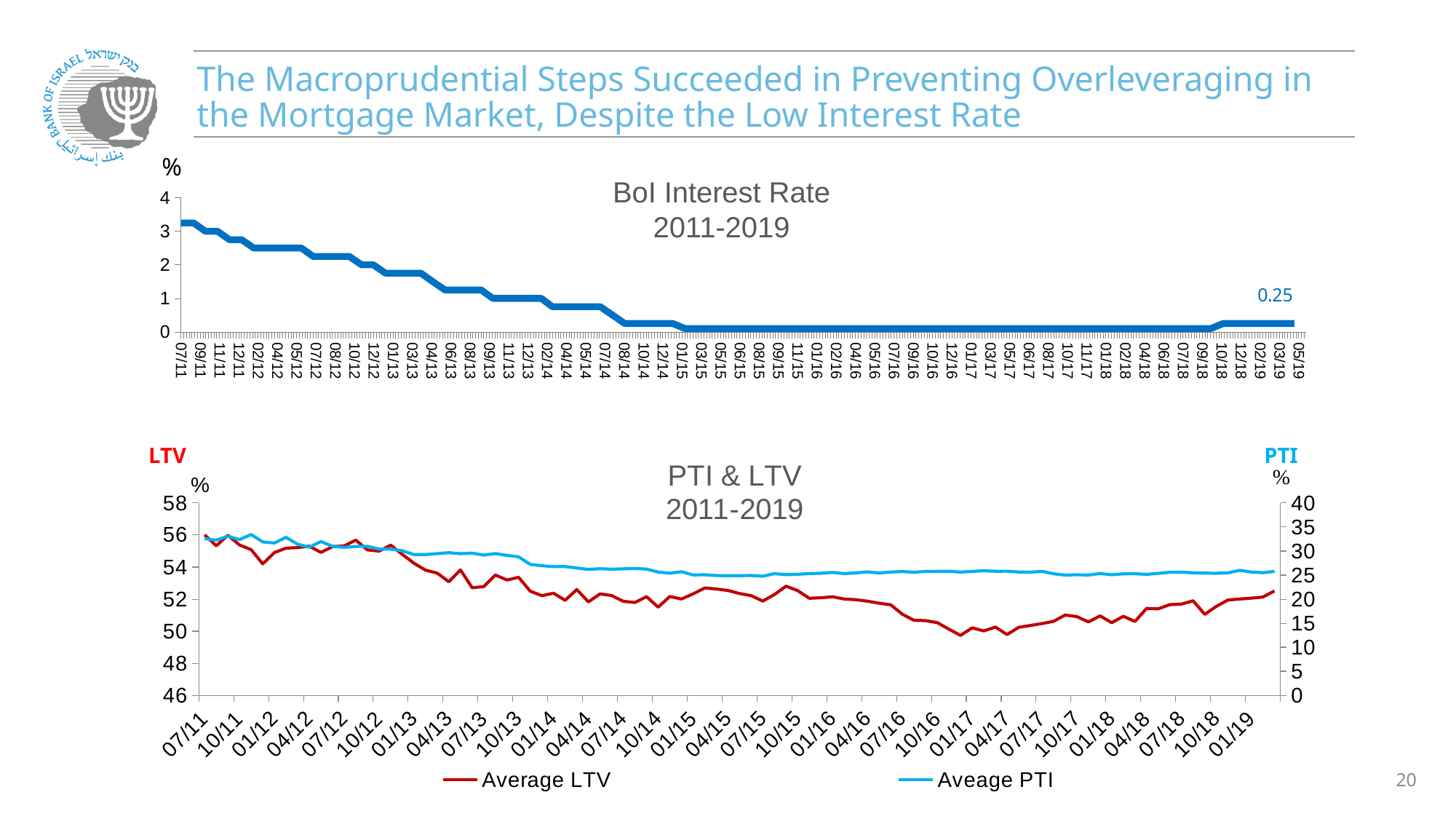
In the 'PTI & LTV 2011-2019' chart, is the Average LTV value for 01/17 greater or less than 52? less In the 'BoI Interest Rate 2011-2019' chart, what value is labelled at the end of the series in 05/19? 0.25 What type of chart is the 'BoI Interest Rate 2011-2019' chart? Line chart How many series does the legend of the 'PTI & LTV 2011-2019' chart list? 2 In the 'PTI & LTV 2011-2019' chart, does the Average LTV series rise or fall overall from 07/11 to 01/19? Fall In the 'PTI & LTV 2011-2019' chart, is the Average LTV value for 07/11 greater or less than 54? greater In the 'PTI & LTV 2011-2019' chart, which series is drawn in red? Average LTV In the 'BoI Interest Rate 2011-2019' chart, does the interest rate rise or fall overall from 07/11 to 05/19? Fall In the 'BoI Interest Rate 2011-2019' chart, is the value for 06/16 greater or less than 1? less